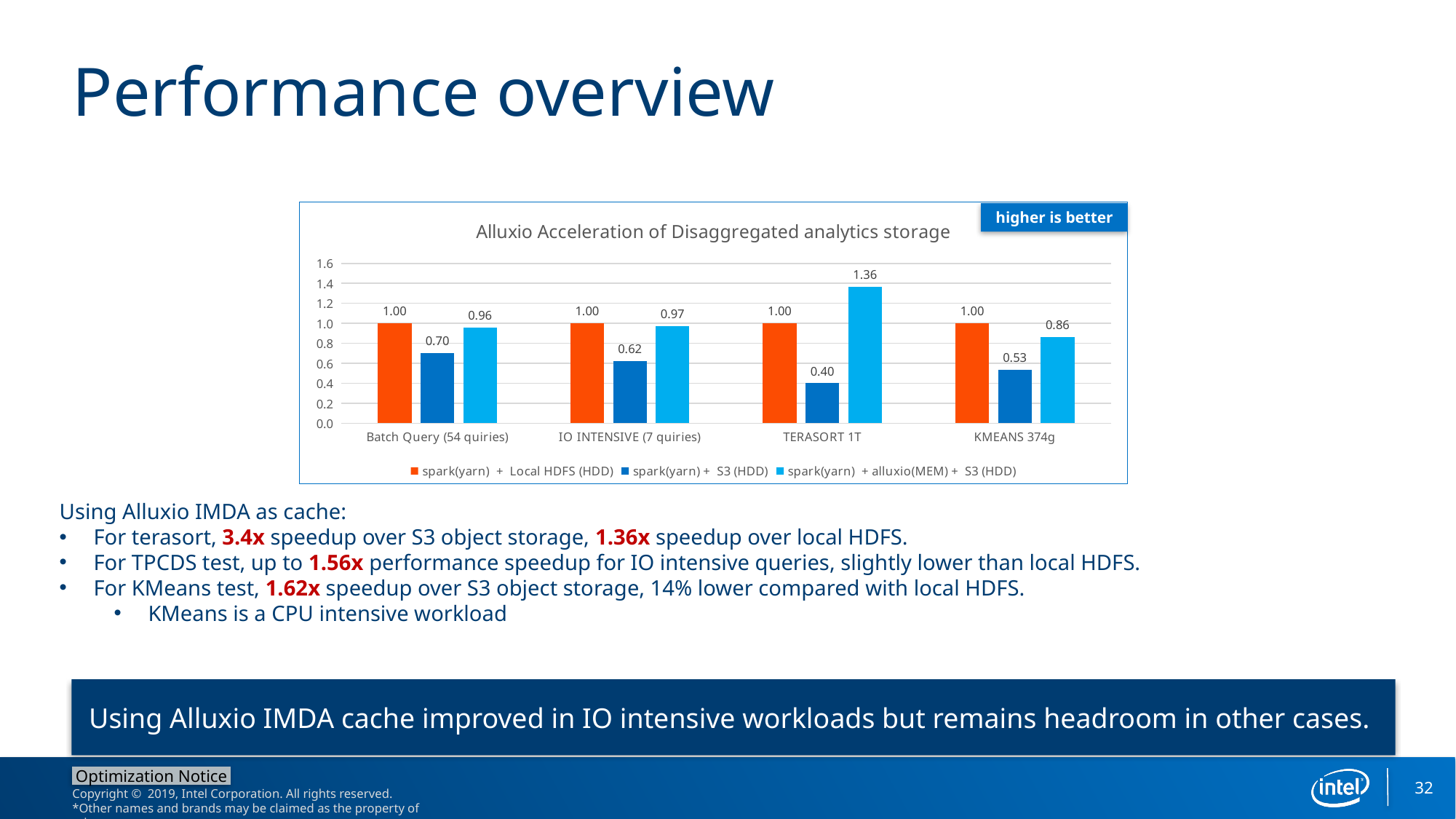
What kind of chart is shown on the slide? bar chart Which category has the lowest value for spark(yarn) + S3 (HDD)? TERASORT 1T What is the value for spark(yarn) + S3 (HDD) for TERASORT 1T? 0.40 Is the value for spark(yarn) + alluxio(MEM) + S3 (HDD) for TERASORT 1T greater or less than 1.2? greater For KMEANS 374g, which is larger: the spark(yarn) + S3 (HDD) value or the spark(yarn) + alluxio(MEM) + S3 (HDD) value? spark(yarn) + alluxio(MEM) + S3 (HDD) What is the value for spark(yarn) + alluxio(MEM) + S3 (HDD) for KMEANS 374g? 0.86 What is the value for spark(yarn) + S3 (HDD) for Batch Query (54 quiries)? 0.70 What is the title of the chart? Alluxio Acceleration of Disaggregated analytics storage How many series does the legend list? 3 Which category has the highest value for spark(yarn) + alluxio(MEM) + S3 (HDD)? TERASORT 1T How many categories are shown on the x axis? 4 What is the difference between the spark(yarn) + alluxio(MEM) + S3 (HDD) value and the spark(yarn) + S3 (HDD) value for IO INTENSIVE (7 quiries)? 0.35